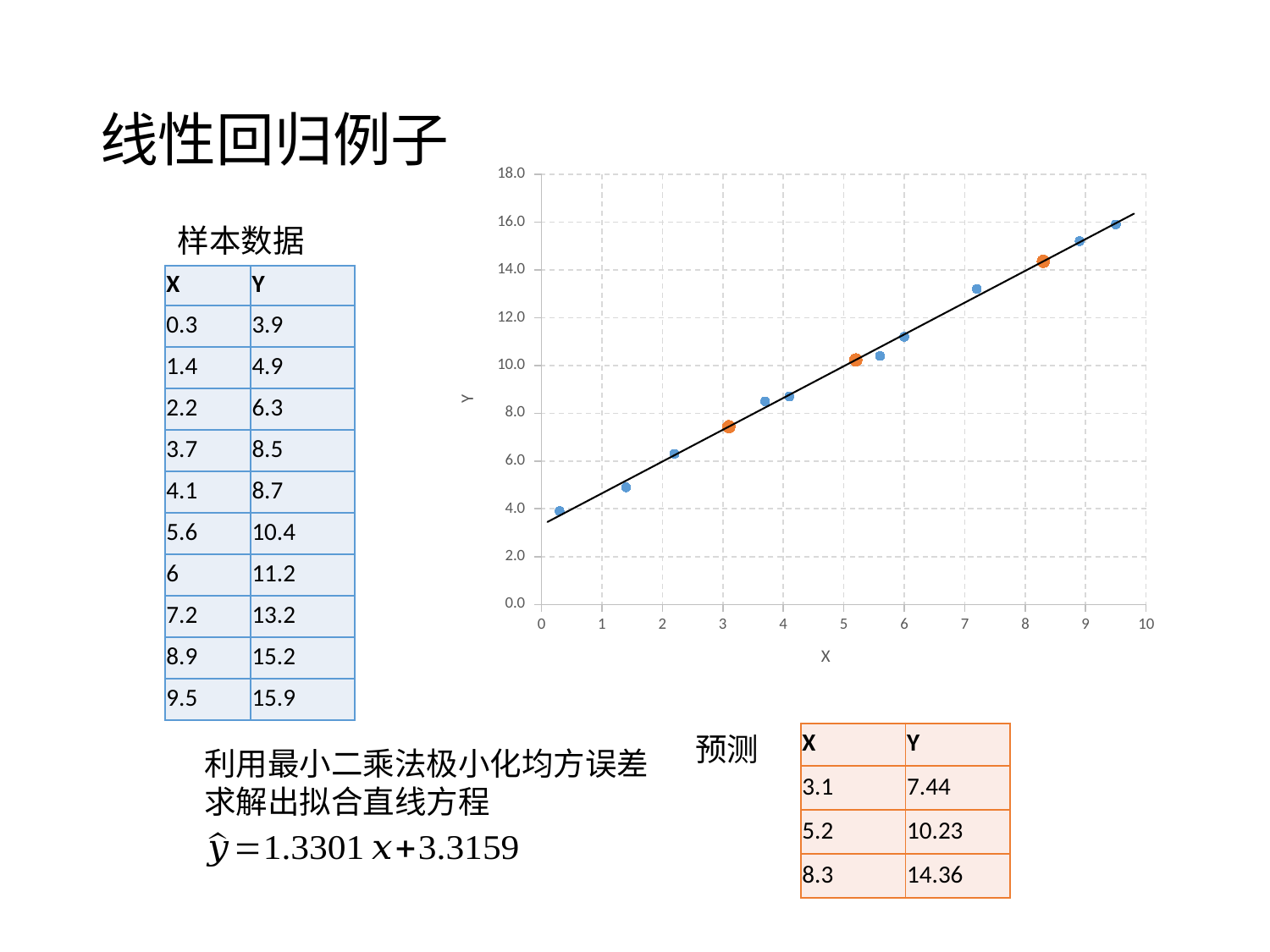
Do the Y values rise or fall as X increases along the x axis? rise How many blue sample data points are plotted on the chart? 10 According to the sample data table, what is the Y value for X = 5.6? 10.4 What is the difference between the highest sample Y value (15.9) and the lowest sample Y value (3.9)? 12.0 Is the Y value of the sample point at X = 1.4 greater or less than 6.0? less Which sample point has the highest Y value on the chart? X = 9.5 (Y = 15.9) What kind of chart is shown on the slide? scatter chart Which sample point has the lowest Y value on the chart? X = 0.3 (Y = 3.9) According to the prediction table, what is the predicted Y value for X = 8.3? 14.36 What is the maximum tick value shown on the chart's x axis? 10 How many orange prediction points are plotted on the chart? 3 Is the Y value of the sample point at X = 7.2 greater or less than 12.0? greater